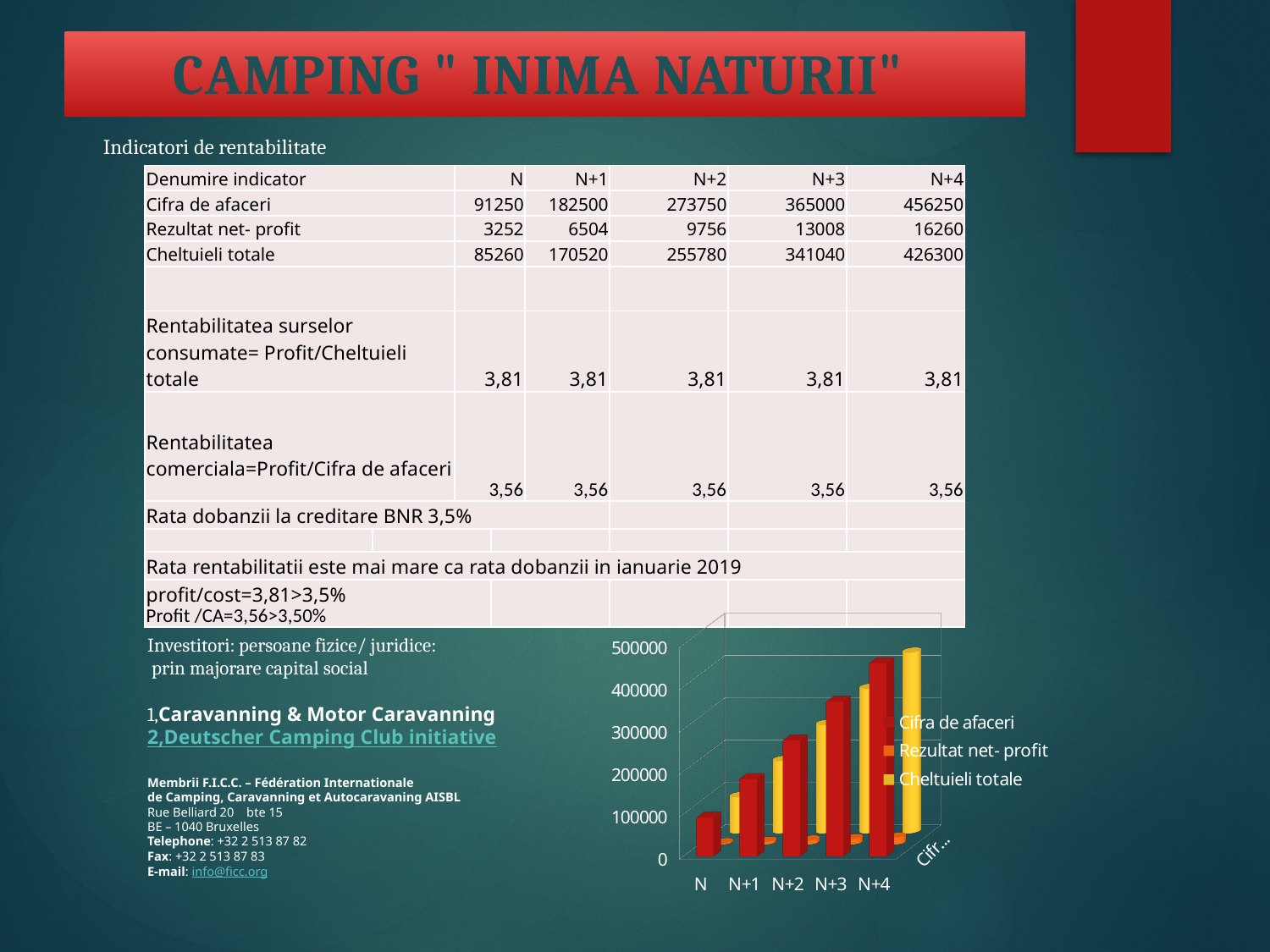
What kind of chart is shown on the slide? bar chart How many series does the chart's legend list? 3 According to the table on the slide, what is the value of Cifra de afaceri at N+2? 273750 Which category has the lowest value for Cheltuieli totale in the chart? N Which is larger in the chart: Cifra de afaceri at N+4 or Cifra de afaceri at N? Cifra de afaceri at N+4 Do the values for Cifra de afaceri rise or fall from N to N+4 in the chart? rise How many categories are shown along the x axis of the chart? 5 Is the value for Rezultat net- profit at N+4 greater or less than 100000? less Which category has the highest value for Cifra de afaceri in the chart? N+4 Which series is shown in yellow in the chart's legend? Cheltuieli totale Is the value for Cifra de afaceri at N+4 greater or less than 400000? greater